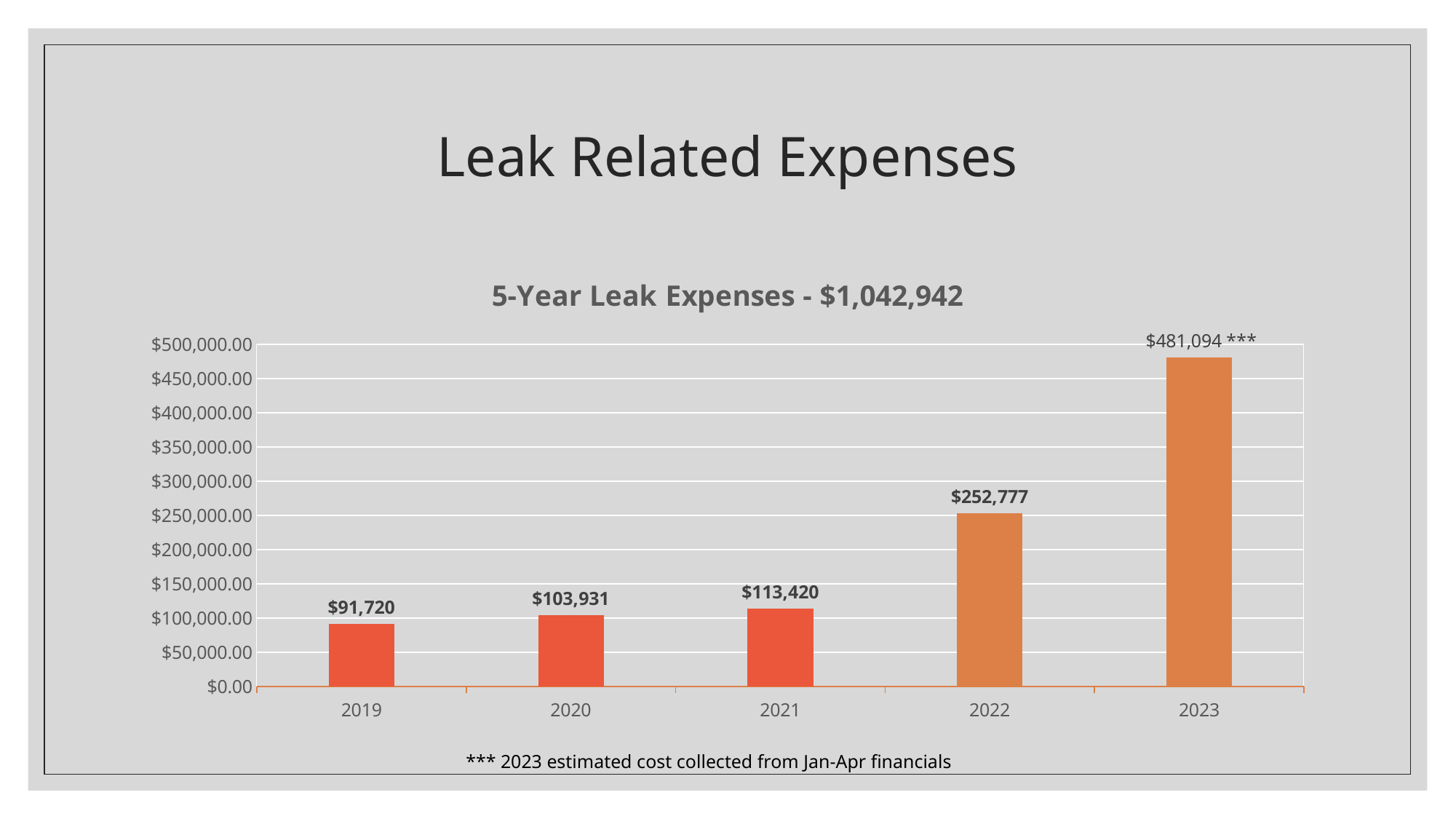
Which year has the larger leak expense, 2020 or 2022? 2022 How many years are shown on the x axis? 5 Is the value for 2022 greater or less than $300,000.00? less What is the leak expense value for 2023? $481,094 What is the leak expense value for 2019? $91,720 Which year has the lowest leak expense? 2019 Do the leak expenses rise or fall from 2019 to 2023? Rise What kind of chart is shown on the slide? Bar chart What is the difference between the leak expenses for 2020 and 2019? $12,211 What is the difference between the leak expenses for 2022 and 2021? $139,357 What is the leak expense value for 2021? $113,420 Which year has the highest leak expense? 2023